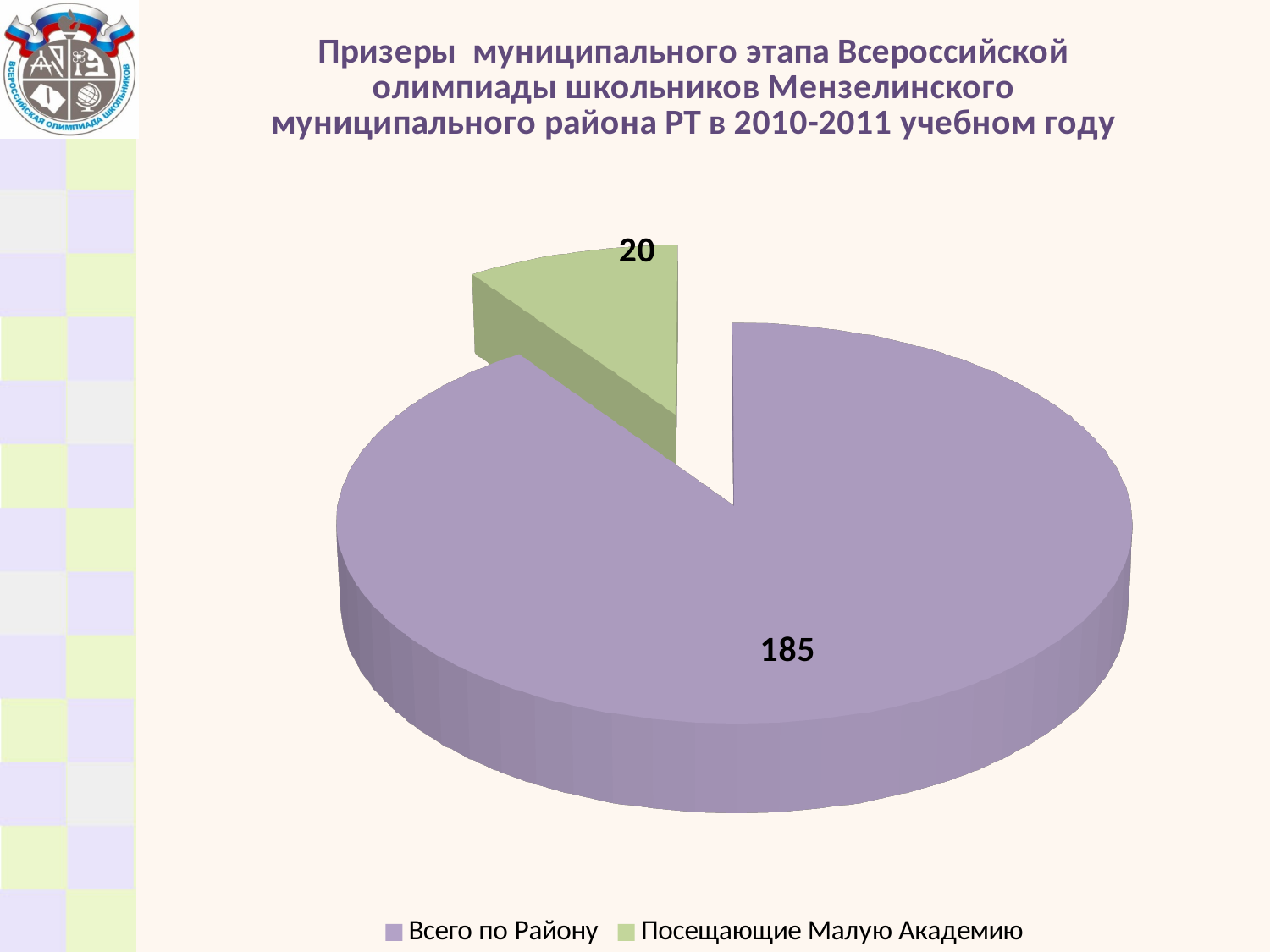
Which academic year is named in the chart title? 2010-2011 Which slice of the pie is the largest? Всего по Району How many entries does the legend list? 2 How many slices does the pie chart have? 2 What colour is the slice for "Посещающие Малую Академию"? green What is the value for "Посещающие Малую Академию"? 20 What type of chart is shown on the slide? pie chart What is the total of the two values shown on the pie chart? 205 What is the difference between the values for "Всего по Району" and "Посещающие Малую Академию"? 165 Which is larger: "Всего по Району" or "Посещающие Малую Академию"? Всего по Району What is the value for "Всего по Району"? 185 Which slice of the pie is the smallest? Посещающие Малую Академию